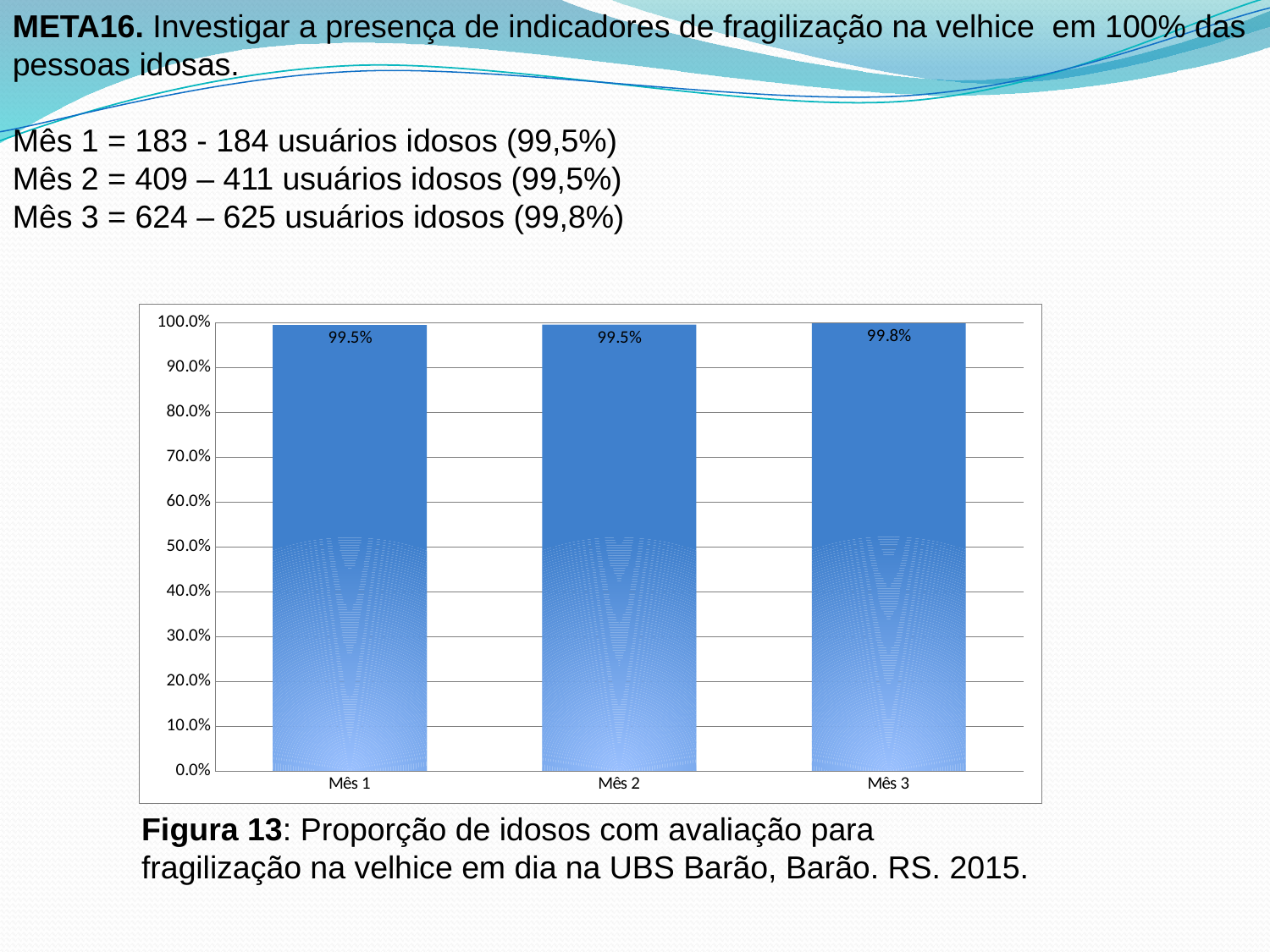
What figure number is given in the caption below the chart? Figura 13 Do the values rise or fall from Mês 1 to Mês 3? rise Is the value for Mês 1 greater or less than 90.0%? greater What is the highest tick value shown on the y axis? 100.0% What is the value for Mês 2? 99.5% What is the value for Mês 3? 99.8% What kind of chart is shown on the slide? bar chart Which month has the highest value? Mês 3 Which is larger, the value for Mês 3 or the value for Mês 2? Mês 3 What is the difference between the values for Mês 3 and Mês 1? 0.3% How many categories are shown on the x axis? 3 What is the value for Mês 1? 99.5%